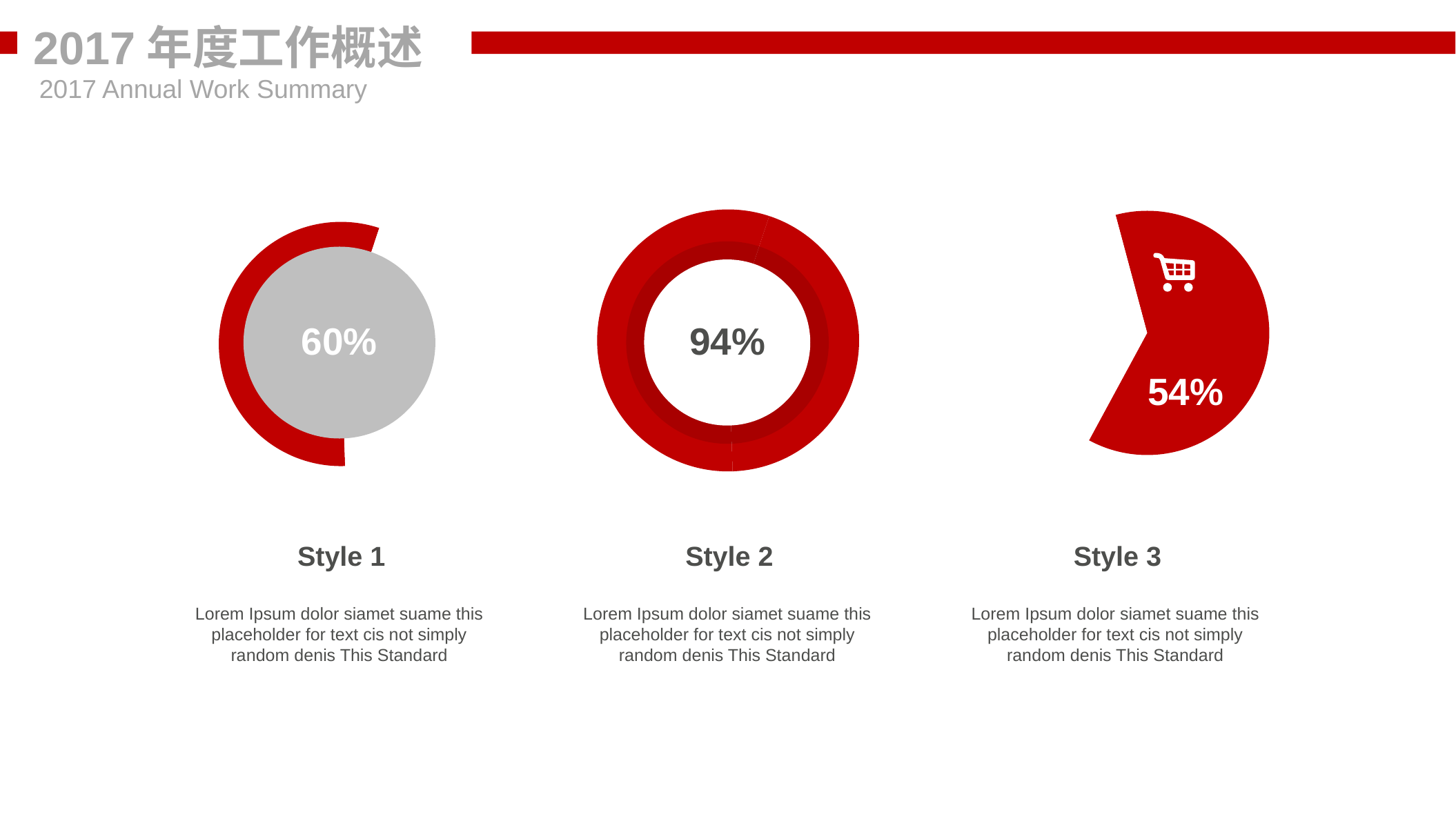
What is the difference between the percentage in the Style 1 chart and the percentage in the Style 3 chart? 6% Which of the three charts (Style 1, Style 2, Style 3) shows the lowest percentage? Style 3 What percentage is shown in the Style 1 chart? 60% How many circular percentage charts are on the slide? 3 What colour is the ring of the Style 2 chart? Red Which shows a larger percentage, the Style 1 chart or the Style 3 chart? Style 1 Which of the three charts (Style 1, Style 2, Style 3) shows the highest percentage? Style 2 What percentage is shown in the Style 3 chart? 54% What kind of chart is the Style 2 chart? Donut chart What percentage is shown in the Style 2 chart? 94% What is the difference between the percentage in the Style 2 chart and the percentage in the Style 3 chart? 40% What is the difference between the percentage in the Style 2 chart and the percentage in the Style 1 chart? 34%